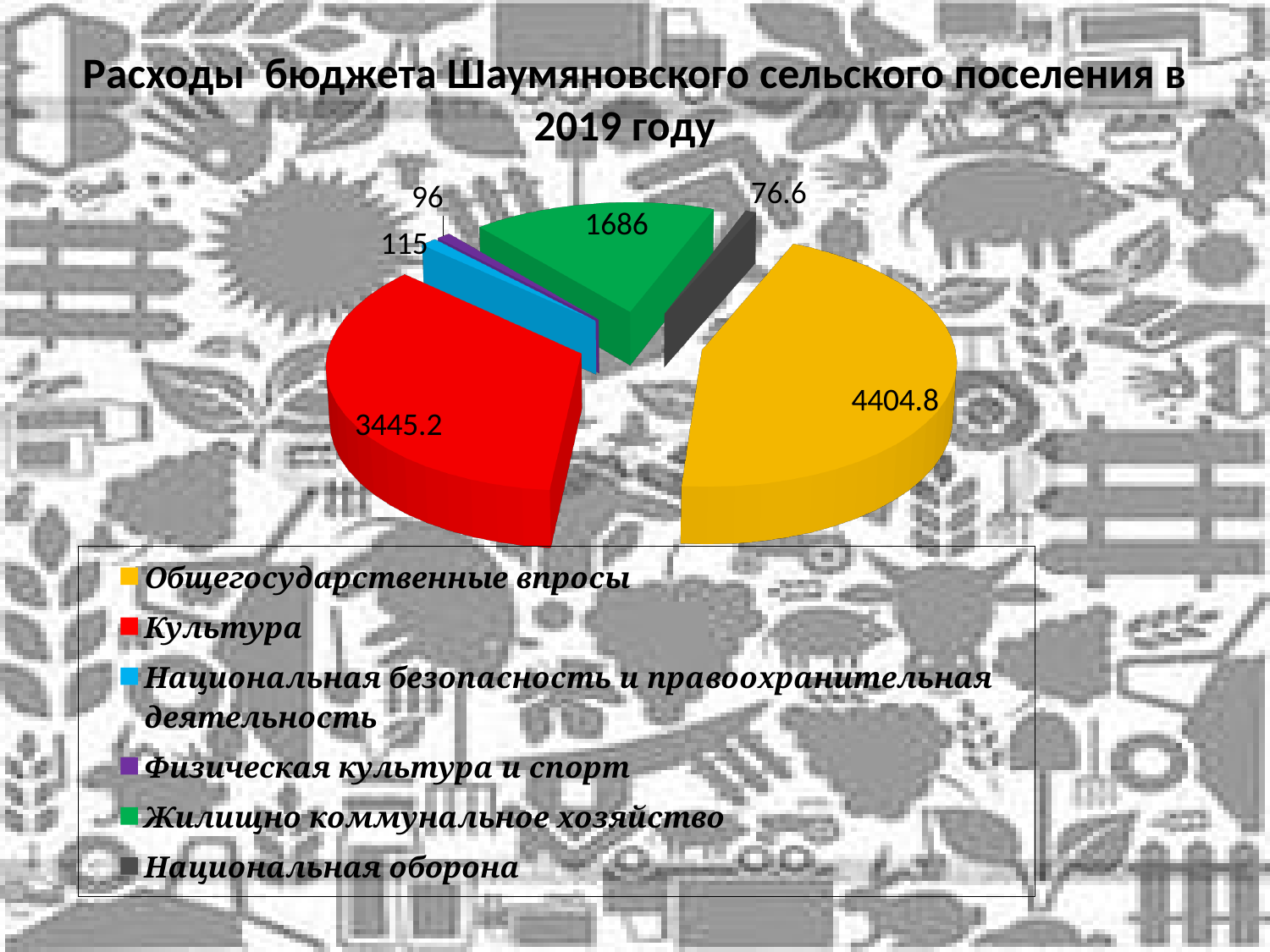
Which category has the smallest value? Национальная оборона What is the value for Общегосударственные впросы? 4404.8 What is the value for Культура? 3445.2 What colour is the slice for Культура? Red Which category has the largest value? Общегосударственные впросы What is the value for Национальная оборона? 76.6 How many categories does the legend list? 6 What is the value for Жилищно коммунальное хозяйство? 1686 What is the difference between the values for Общегосударственные впросы and Культура? 959.6 Which is larger, the value for Национальная безопасность и правоохранительная деятельность or the value for Физическая культура и спорт? Национальная безопасность и правоохранительная деятельность What is the value for Физическая культура и спорт? 96 What type of chart is shown on the slide? Pie chart